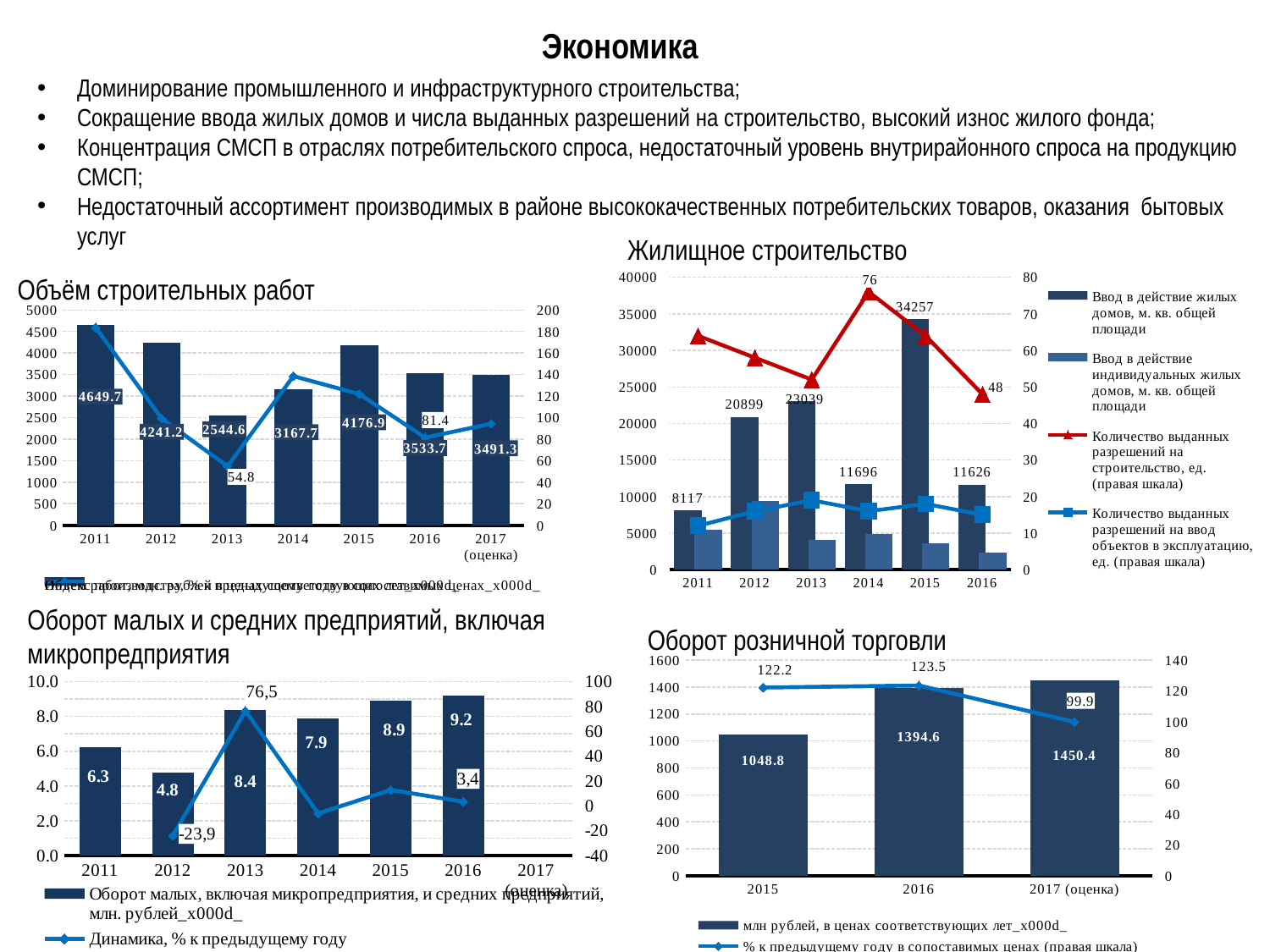
In the 'Объём строительных работ' chart, what is the bar value for 2011? 4649.7 In the 'Объём строительных работ' chart, which year has the lowest bar? 2013 In the 'Жилищное строительство' chart, is the dark bar for 2012 larger or smaller than the dark bar for 2014? larger In the 'Оборот малых и средних предприятий, включая микропредприятия' chart, which year has the highest bar? 2016 In the 'Оборот розничной торговли' chart, do the bar values rise or fall from 2015 to 2017 (оценка)? rise In the 'Жилищное строительство' chart, what is the value of the red line (permits issued) in 2014? 76 In the 'Жилищное строительство' chart, what is the labelled value of the dark bar for 2015? 34257 In the 'Жилищное строительство' chart, how many series does the legend list? 4 In the 'Оборот малых и средних предприятий, включая микропредприятия' chart, what is the value of the 'Динамика' line in 2012? -23,9 In the 'Оборот малых и средних предприятий, включая микропредприятия' chart, what is the bar value for 2016? 9.2 In the 'Оборот розничной торговли' chart, what is the bar value for 2016? 1394.6 In the 'Объём строительных работ' chart, what is the difference between the bar values for 2015 and 2016? 643.2